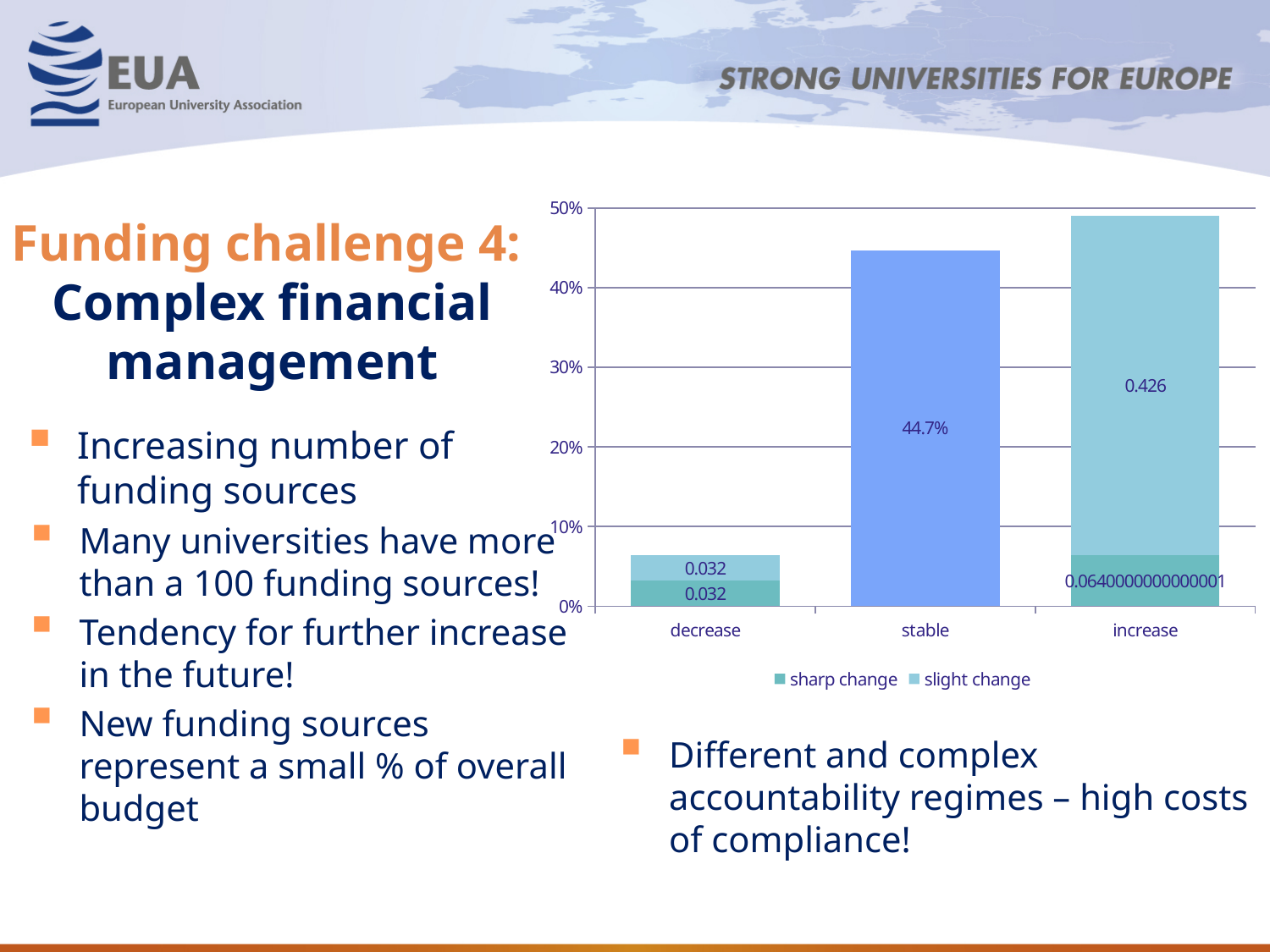
What are the two series named in the chart legend? sharp change, slight change What kind of chart is shown on the slide? bar chart What is the 'slight change' value labelled for the 'increase' category? 0.426 How many series does the chart legend list? 2 Do the bar heights rise or fall moving from 'decrease' to 'increase' along the x axis? rise What is the data label shown on the 'stable' bar? 44.7% Which category has the shortest bar overall? decrease Which bar is taller, 'stable' or 'decrease'? stable Which category has the tallest bar overall? increase Is the total bar height for 'increase' greater or less than 40%? greater What is the 'sharp change' value labelled for the 'decrease' category? 0.032 How many categories are shown on the x axis of the chart? 3